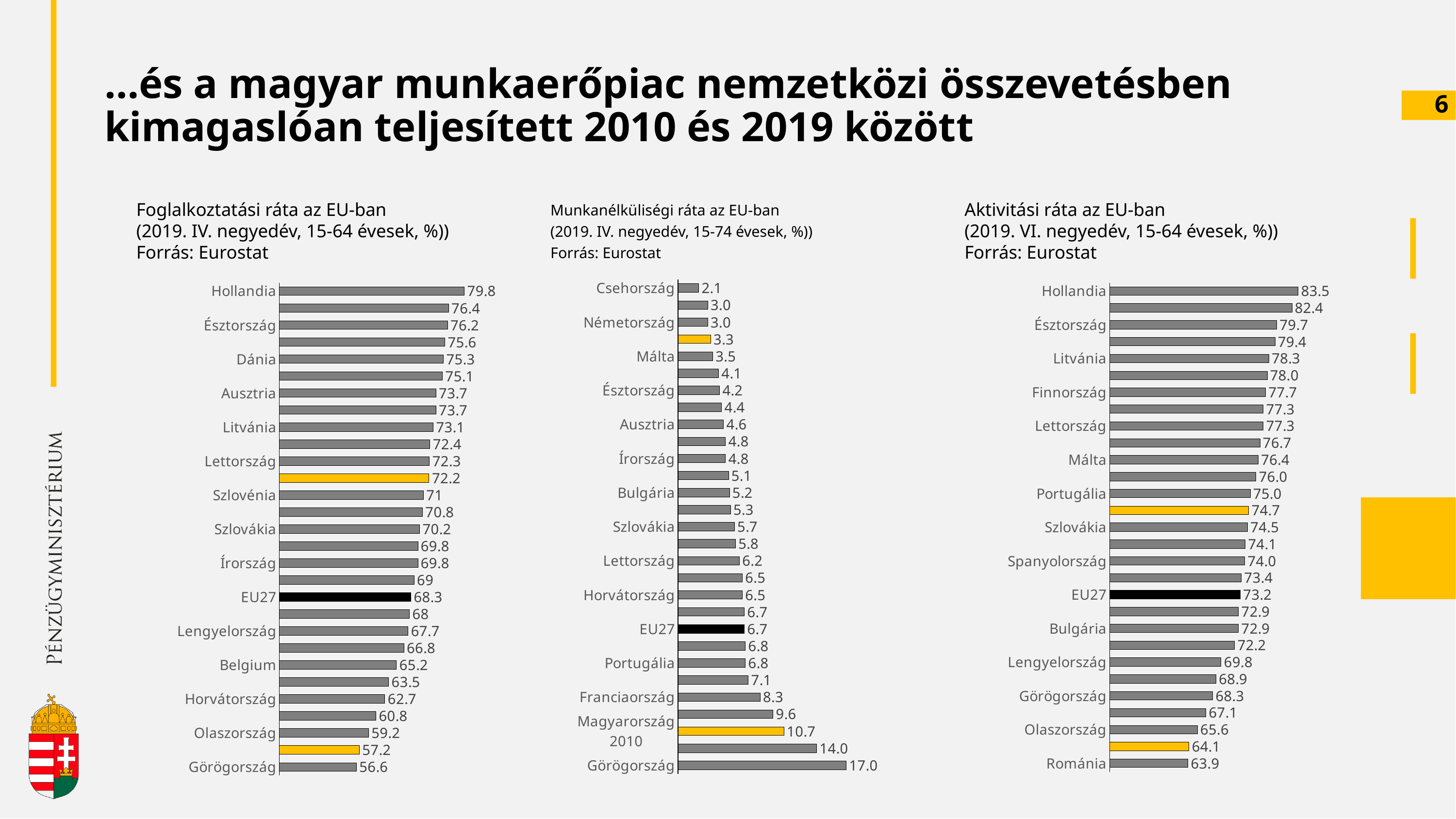
In the chart 'Aktivitási ráta az EU-ban', what is the value for Hollandia? 83.5 In the chart 'Munkanélküliségi ráta az EU-ban', what is the value for Csehország? 2.1 In the chart 'Munkanélküliségi ráta az EU-ban', which country has the highest value? Görögország In the chart 'Aktivitási ráta az EU-ban', what is the difference between EU27 and Olaszország? 7.6 What type of chart is the 'Aktivitási ráta az EU-ban' chart? Bar chart In the chart 'Munkanélküliségi ráta az EU-ban', which is larger, the value for Franciaország or the value for Portugália? Franciaország In the chart 'Foglalkoztatási ráta az EU-ban', what is the value for Hollandia? 79.8 In the chart 'Foglalkoztatási ráta az EU-ban', what is the difference between Hollandia and Görögország? 23.2 In the chart 'Foglalkoztatási ráta az EU-ban', what is the value for EU27? 68.3 In the chart 'Aktivitási ráta az EU-ban', what is the value for Románia? 63.9 In the chart 'Munkanélküliségi ráta az EU-ban', what is the value for EU27? 6.7 In the chart 'Foglalkoztatási ráta az EU-ban', which labelled country has the lowest value? Görögország